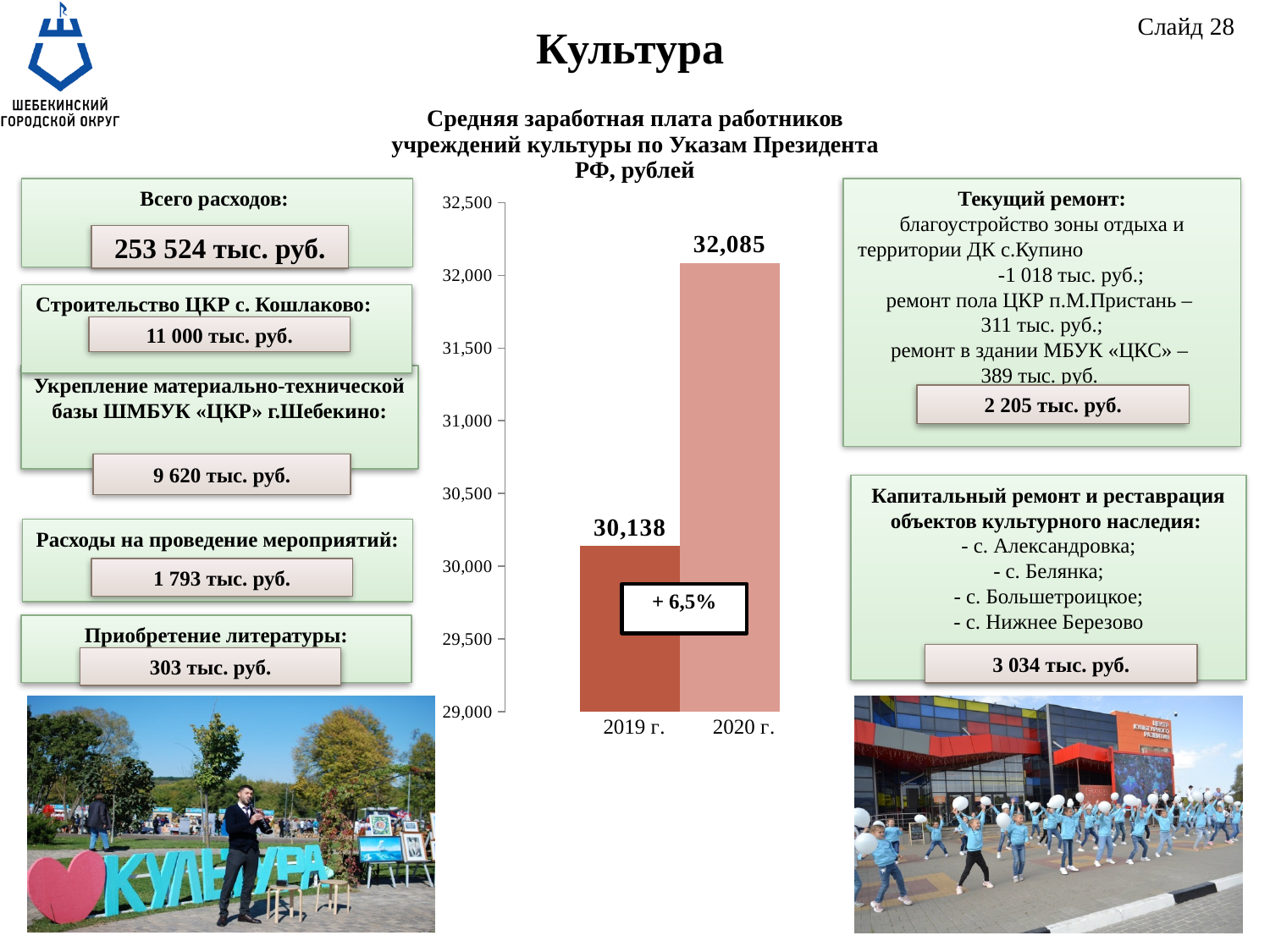
How many bars are plotted on the chart? 2 What is the average salary value shown for 2019 г.? 30,138 What kind of chart is shown on the slide? bar chart What is the average salary value shown for 2020 г.? 32,085 Do the values rise or fall from 2019 г. to 2020 г.? rise What is the title of the chart? Средняя заработная плата работников учреждений культуры по Указам Президента РФ, рублей What is the difference between the 2020 г. and 2019 г. values on the chart? 1,947 Is the value for 2020 г. greater or less than 32,000? greater Which year has the higher average salary on the chart? 2020 г. What percentage change is printed on the chart between the two bars? + 6,5% Which year has the lower average salary on the chart? 2019 г. Is the value for 2019 г. greater or less than 30,500? less